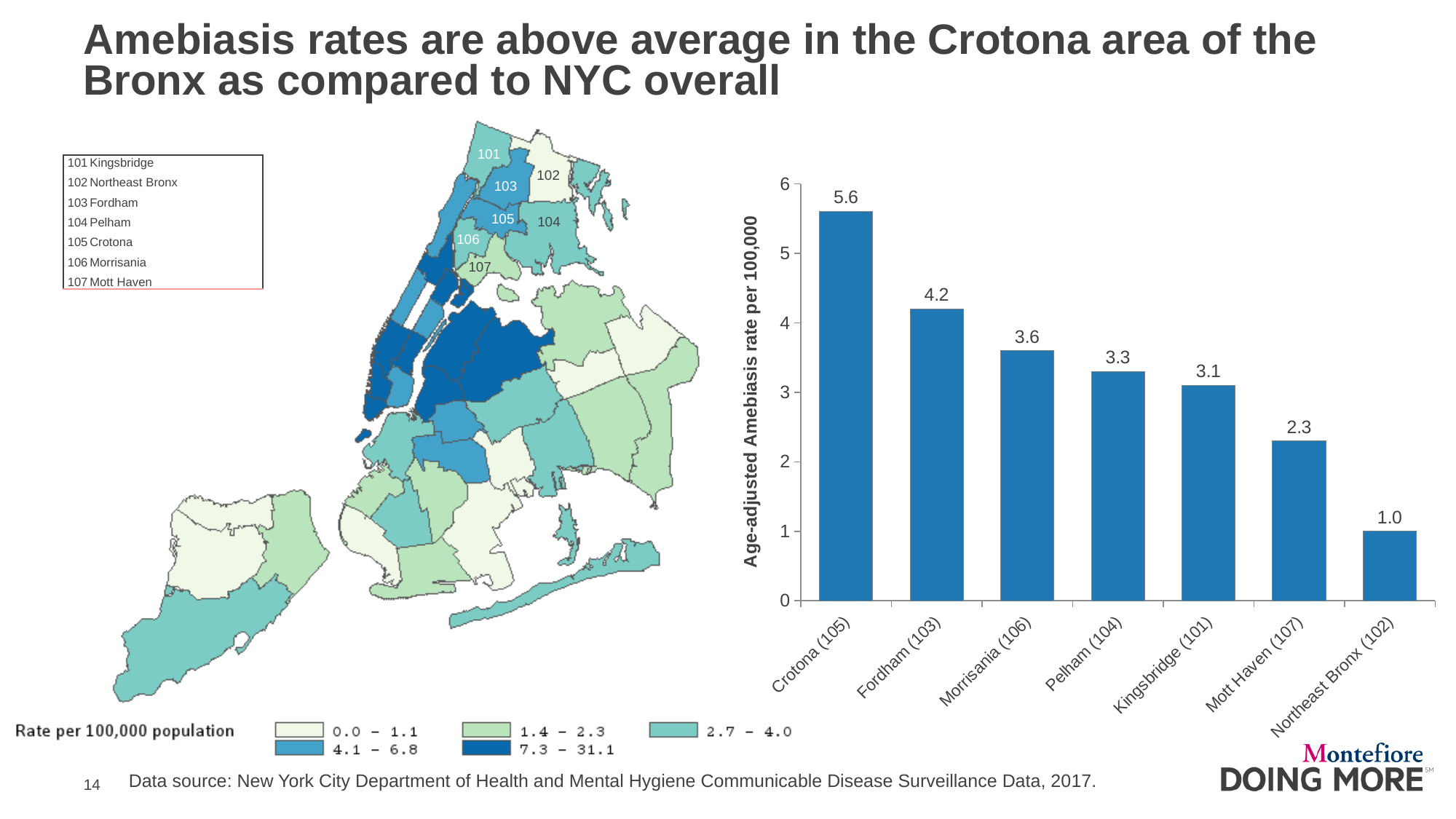
In the bar chart, which neighborhood has the highest age-adjusted Amebiasis rate? Crotona (105) In the bar chart, what is the difference between the Amebiasis rates for Crotona (105) and Fordham (103)? 1.4 In the bar chart, what is the age-adjusted Amebiasis rate per 100,000 for Mott Haven (107)? 2.3 In the bar chart, what is the age-adjusted Amebiasis rate per 100,000 for Pelham (104)? 3.3 In the bar chart, is the value for Fordham (103) greater or less than 4? greater What is the y-axis label of the bar chart? Age-adjusted Amebiasis rate per 100,000 In the bar chart, which has a higher Amebiasis rate, Kingsbridge (101) or Mott Haven (107)? Kingsbridge (101) In the bar chart, what is the difference between the Amebiasis rates for Morrisania (106) and Northeast Bronx (102)? 2.6 How many neighborhoods are shown in the bar chart? 7 In the bar chart, what is the age-adjusted Amebiasis rate per 100,000 for Crotona (105)? 5.6 What kind of chart is shown on the right side of the slide? Bar chart In the bar chart, which neighborhood has the lowest age-adjusted Amebiasis rate? Northeast Bronx (102)